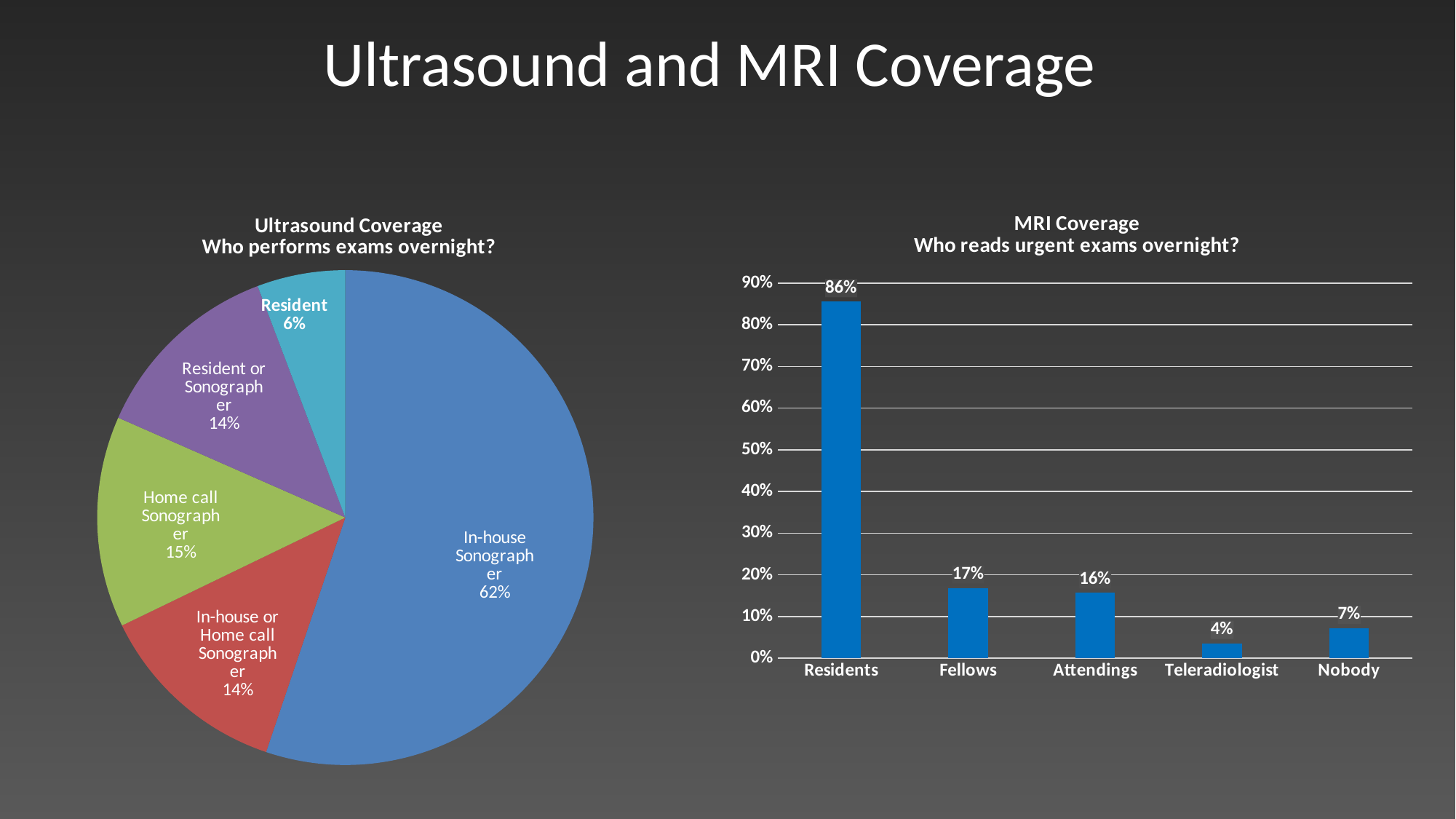
In the MRI Coverage chart, which is larger, Nobody or Teleradiologist? Nobody In the MRI Coverage chart, which category has the lowest value? Teleradiologist What kind of chart is the Ultrasound Coverage chart? Pie chart In the Ultrasound Coverage pie chart, which category has the smallest slice? Resident In the MRI Coverage chart, what is the difference between Residents and Fellows? 69% What kind of chart is the MRI Coverage chart? Bar chart In the Ultrasound Coverage pie chart, what share of the pie is In-house Sonographer? 62% In the MRI Coverage chart, what is the value for Teleradiologist? 4% In the Ultrasound Coverage pie chart, how many slices are there? 5 In the Ultrasound Coverage pie chart, what is the value for Home call Sonographer? 15% In the MRI Coverage chart, how many categories are shown on the x axis? 5 In the MRI Coverage chart, what is the value for Residents? 86%